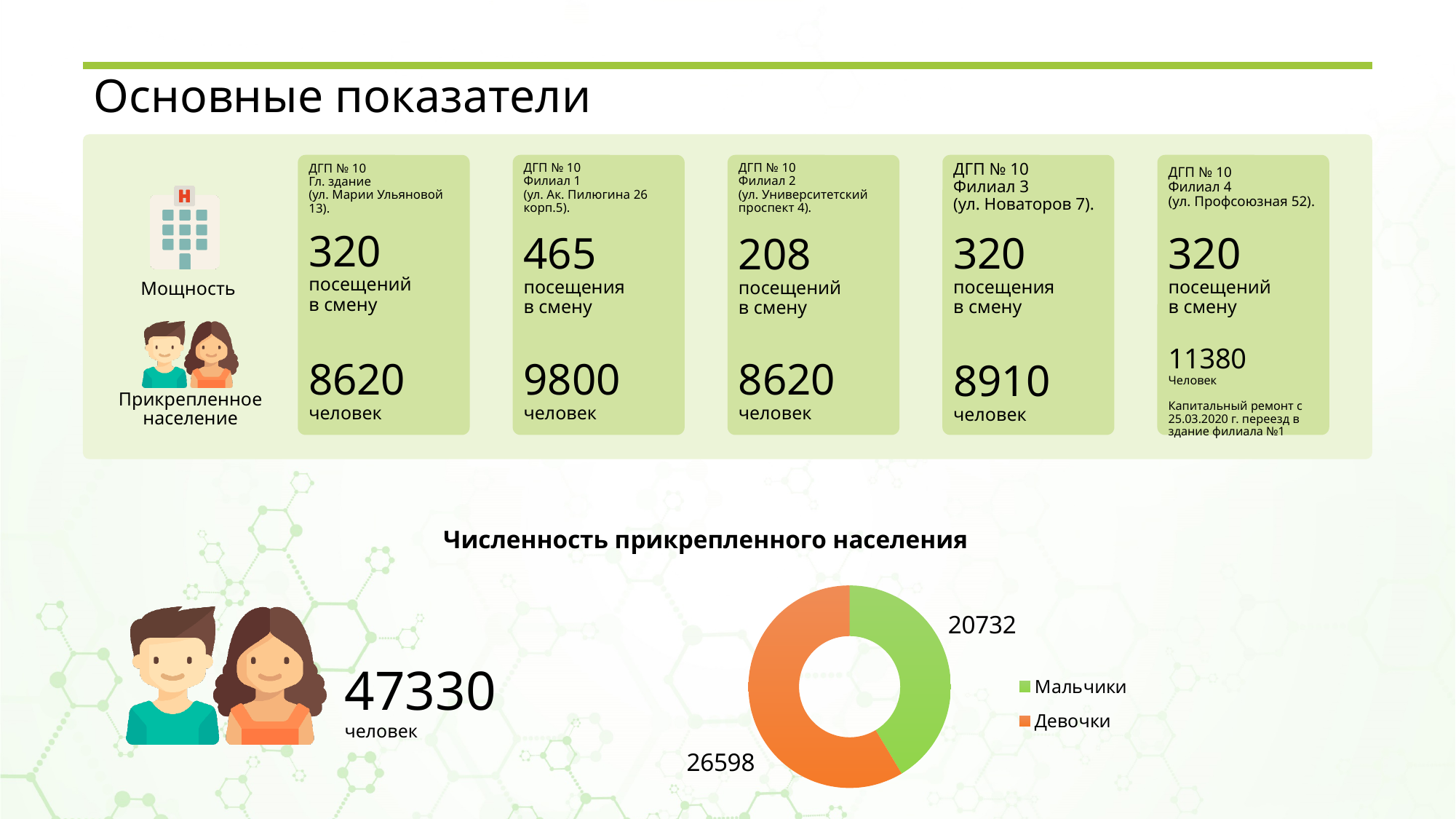
What kind of chart is shown under the heading Численность прикрепленного населения? Donut (pie) chart How many slices does the donut chart have? 2 What is the value for Девочки in the donut chart? 26598 Which category has the largest slice in the donut chart? Девочки How many entries does the legend of the donut chart list? 2 What is the total of the two slices in the donut chart? 47330 What is the value for Мальчики in the donut chart? 20732 What is the difference between the values for Девочки and Мальчики in the donut chart? 5866 Which category has the smallest slice in the donut chart? Мальчики What share of the donut chart does Девочки represent? 56.2% Which is larger in the donut chart, Мальчики or Девочки? Девочки What colour is the Мальчики slice in the donut chart? Green